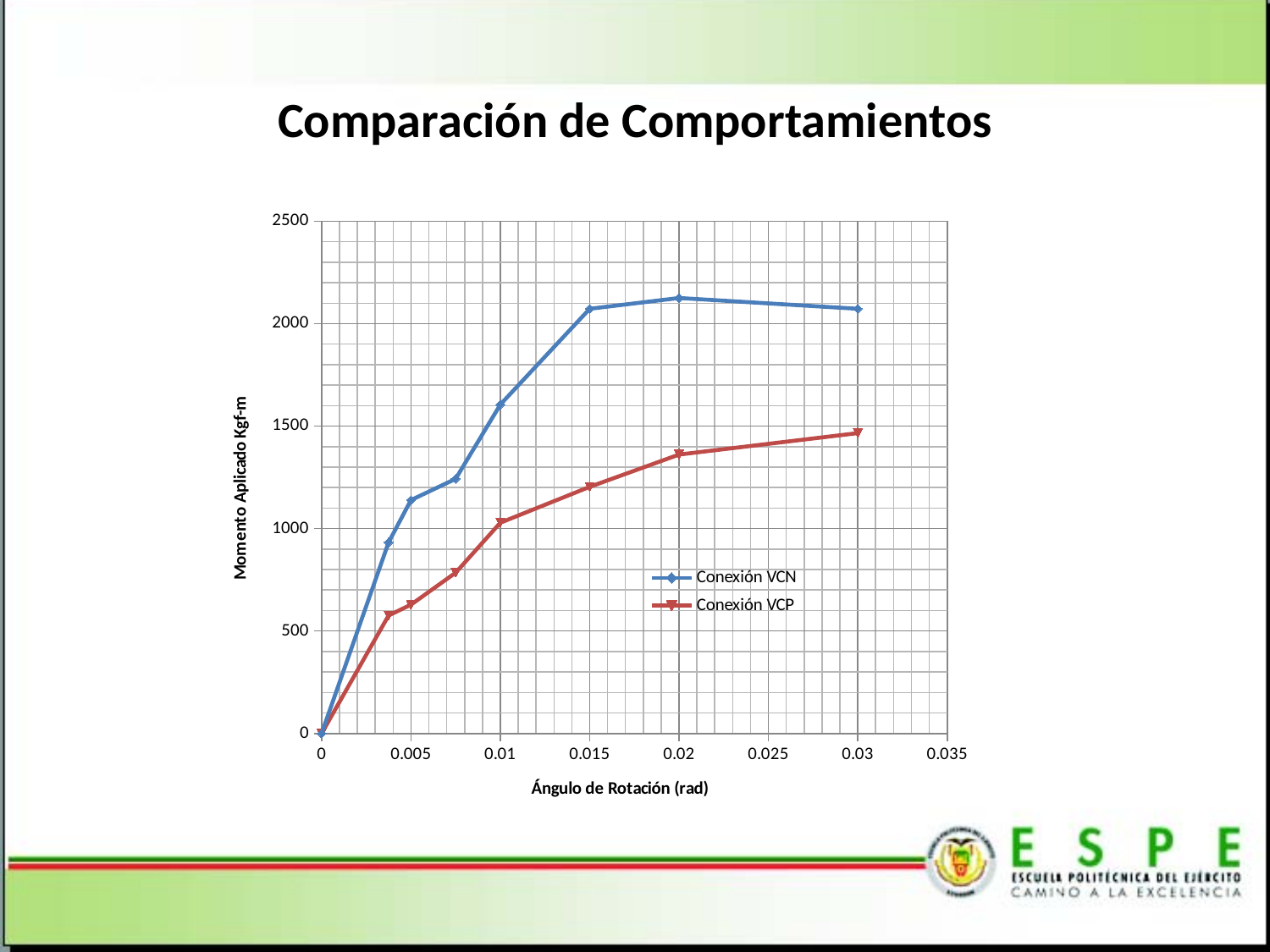
Do the values for Conexión VCP rise or fall as the rotation angle increases? rise Is the value for Conexión VCP at 0.02 rad greater or less than 1500? less What is the title of the chart? Comparación de Comportamientos Is the value for Conexión VCP at 0.03 rad greater or less than 1500? less At 0.03 rad, which series has the larger value, Conexión VCN or Conexión VCP? Conexión VCN What kind of chart is shown on the slide? line chart Is the value for Conexión VCN at 0.005 rad greater or less than 1000? greater At 0.015 rad, which series has the larger value, Conexión VCN or Conexión VCP? Conexión VCN How many series does the legend list? 2 What is the label of the x axis? Ángulo de Rotación (rad)